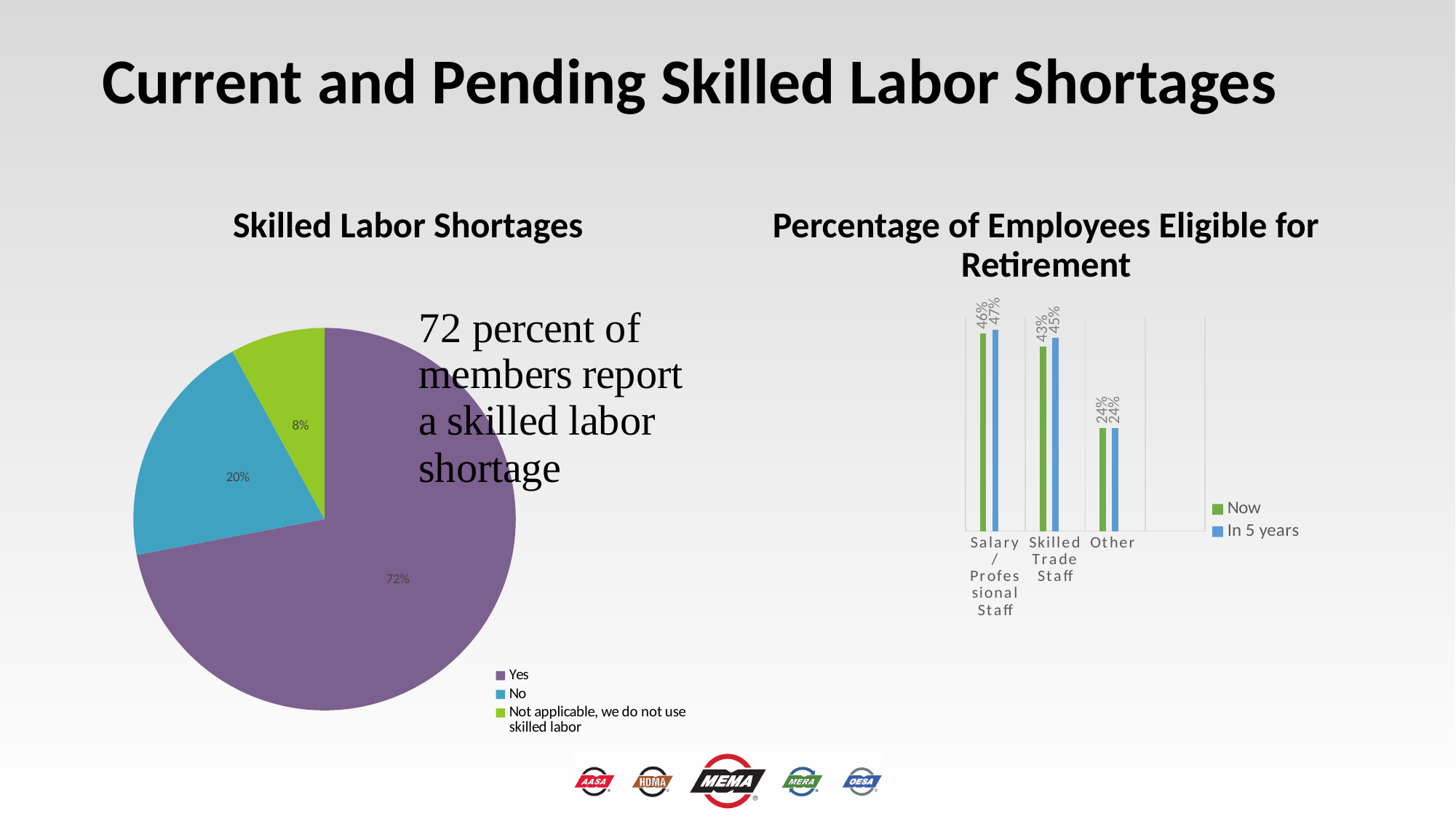
In the 'Skilled Labor Shortages' chart, which category has the largest slice? Yes How many series does the legend of the 'Percentage of Employees Eligible for Retirement' chart list? 2 In the 'Skilled Labor Shortages' chart, what share of the pie is 'Yes'? 72% In the 'Percentage of Employees Eligible for Retirement' chart, what is the 'Now' value for Skilled Trade Staff? 43% In the 'Percentage of Employees Eligible for Retirement' chart, which category has the lowest 'Now' value? Other In the 'Skilled Labor Shortages' chart, what share of the pie is 'No'? 20% In the 'Percentage of Employees Eligible for Retirement' chart, what is the difference between the 'In 5 years' and 'Now' values for Skilled Trade Staff? 2% What kind of chart is 'Skilled Labor Shortages'? Pie chart In the 'Percentage of Employees Eligible for Retirement' chart, what is the 'In 5 years' value for Salary / Professional Staff? 47% In the 'Skilled Labor Shortages' chart, which category has the smallest slice? Not applicable, we do not use skilled labor What kind of chart is 'Percentage of Employees Eligible for Retirement'? Bar chart In the 'Skilled Labor Shortages' chart, what share of the pie is 'Not applicable, we do not use skilled labor'? 8%